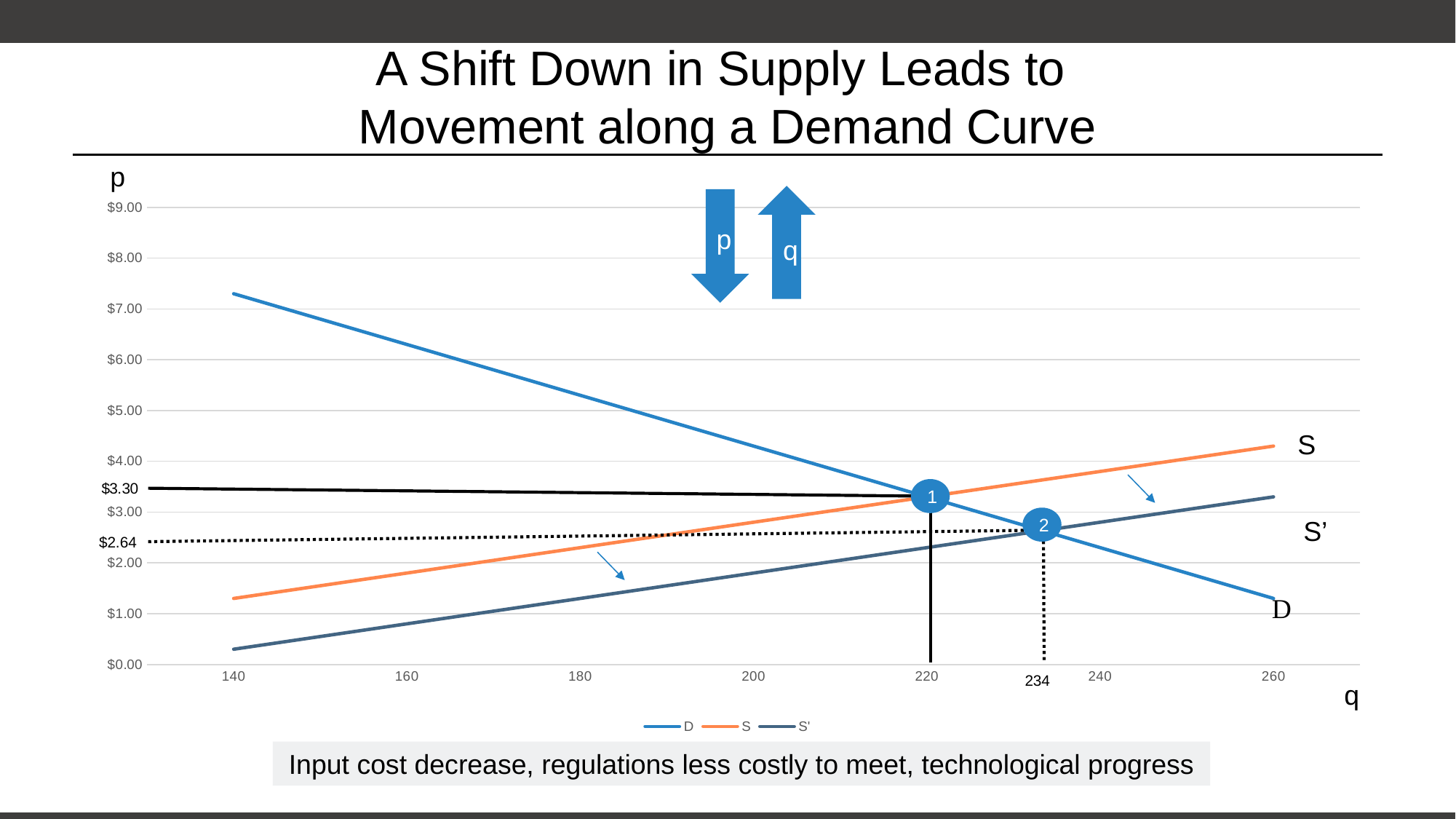
By how much does the price fall from equilibrium point 1 to equilibrium point 2? $0.66 What is the quantity at equilibrium point 2? 234 Which equilibrium point has the higher price, point 1 or point 2? point 1 What is the price at equilibrium point 1? $3.30 Is the value of the D line at q = 140 greater or less than $7.00? greater What is the price at equilibrium point 2? $2.64 Does the D line rise or fall as q increases? fall What are the series names listed in the chart legend? D, S, S' What is the quantity at equilibrium point 1? 220 What kind of chart is shown on the slide? line chart How many series does the chart legend list? 3 By how much does the quantity increase from equilibrium point 1 to equilibrium point 2? 14